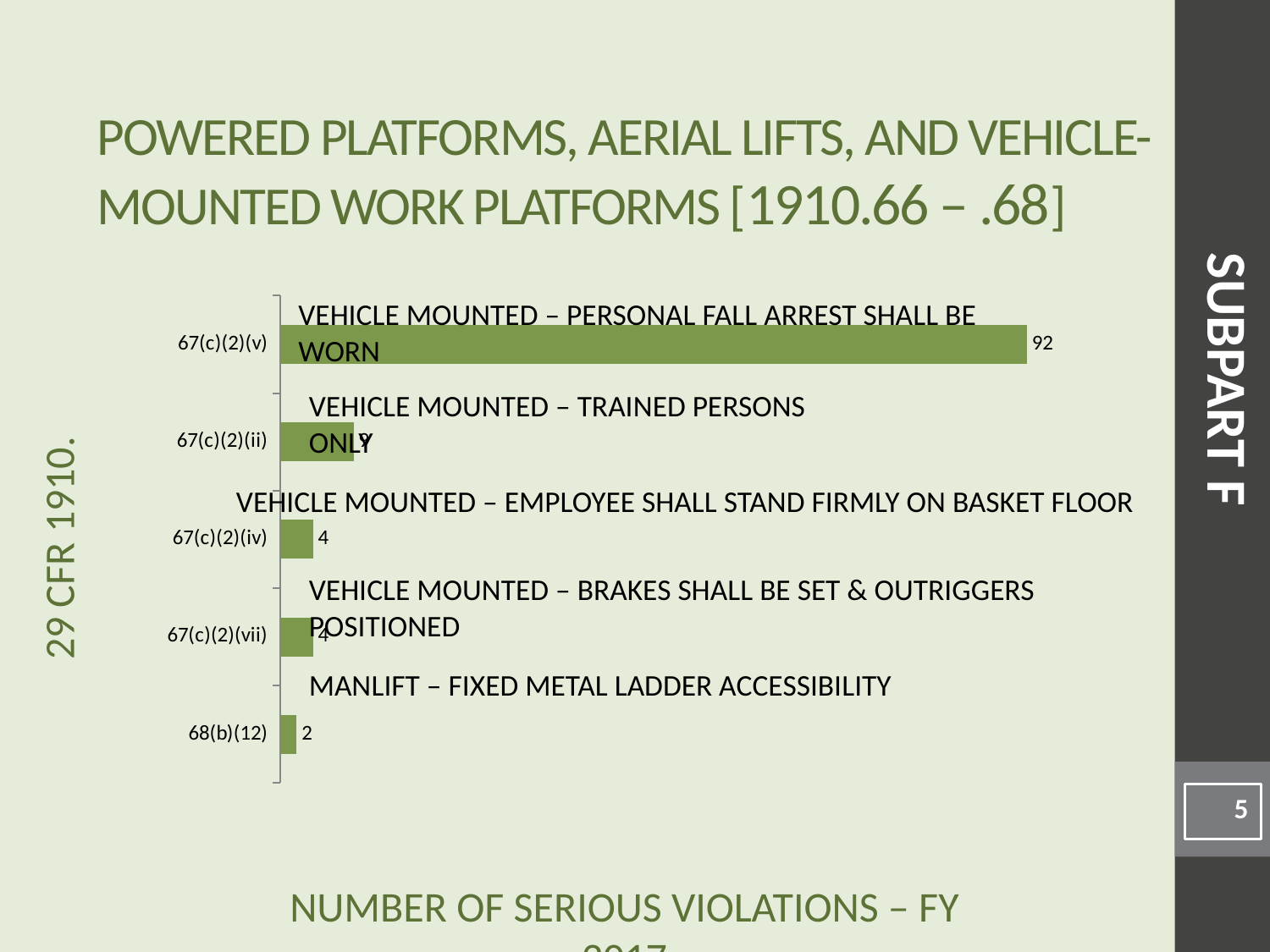
Which category has the highest number of serious violations? 67(c)(2)(v) What is the difference between the values for 67(c)(2)(v) and 67(c)(2)(iv)? 88 Which category has the lowest number of serious violations? 68(b)(12) What is the value for 67(c)(2)(v)? 92 How many categories are shown in the chart? 5 What kind of chart is shown on the slide? Bar chart What is the difference between the values for 67(c)(2)(iv) and 68(b)(12)? 2 What is the value for 67(c)(2)(iv)? 4 What description is given for the 68(b)(12) category? MANLIFT – FIXED METAL LADDER ACCESSIBILITY Which has a larger value, 67(c)(2)(ii) or 67(c)(2)(iv)? 67(c)(2)(ii) Which has a larger value, 67(c)(2)(v) or 68(b)(12)? 67(c)(2)(v) What is the value for 68(b)(12)? 2